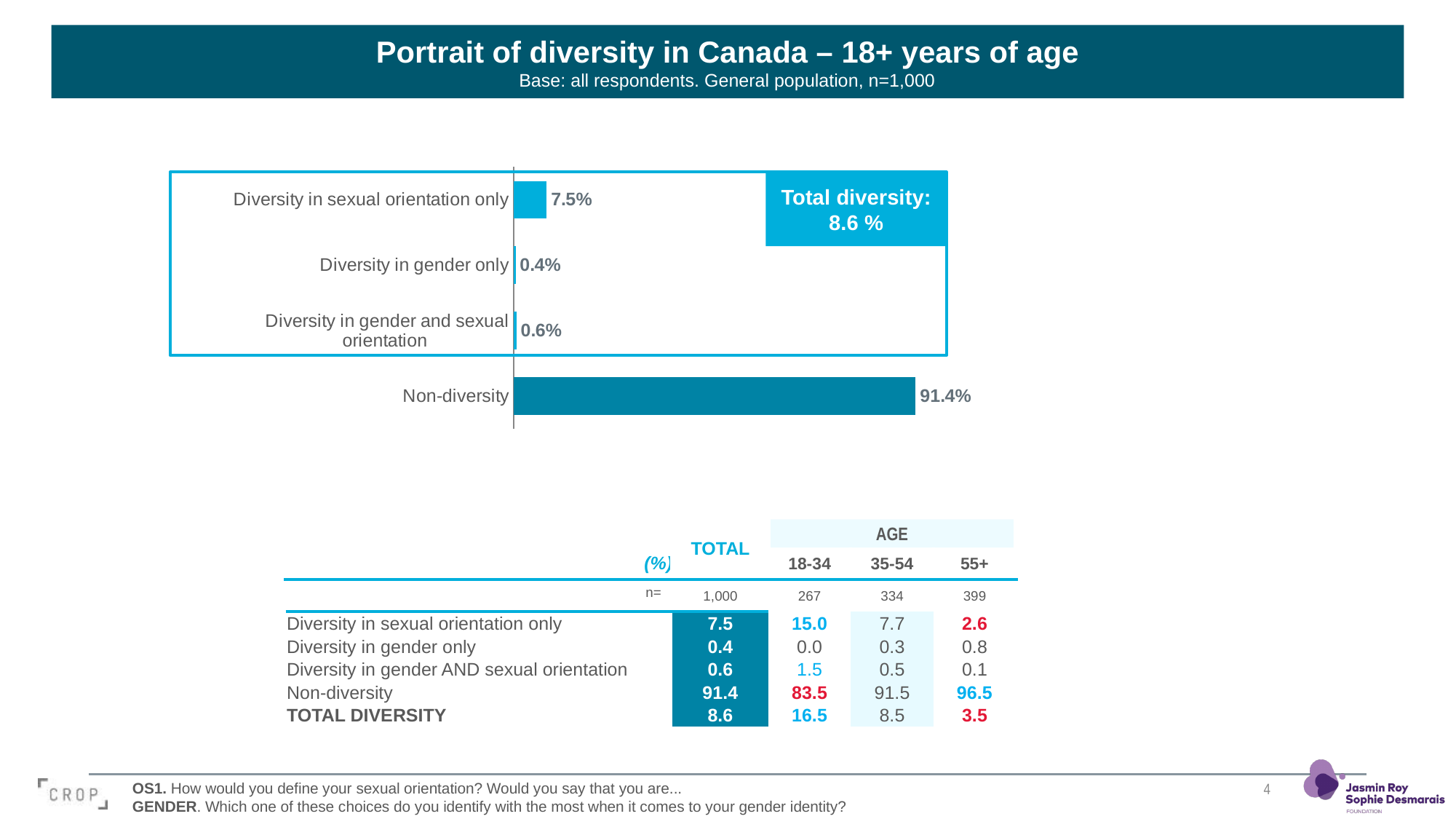
Which category has the highest value? Non-diversity What is the value for Diversity in gender only? 0.4% What kind of chart is shown on the slide? Bar chart Which category has the lowest value? Diversity in gender only What total diversity figure is shown in the box on the chart? 8.6 % What is the value for Diversity in sexual orientation only? 7.5% Which is larger: Diversity in gender only or Diversity in gender and sexual orientation? Diversity in gender and sexual orientation What is the value for Diversity in gender and sexual orientation? 0.6% What is the difference between Non-diversity and Diversity in sexual orientation only? 83.9% How many categories are shown in the chart? 4 What is the title of the slide containing the chart? Portrait of diversity in Canada – 18+ years of age What is the value for Non-diversity? 91.4%